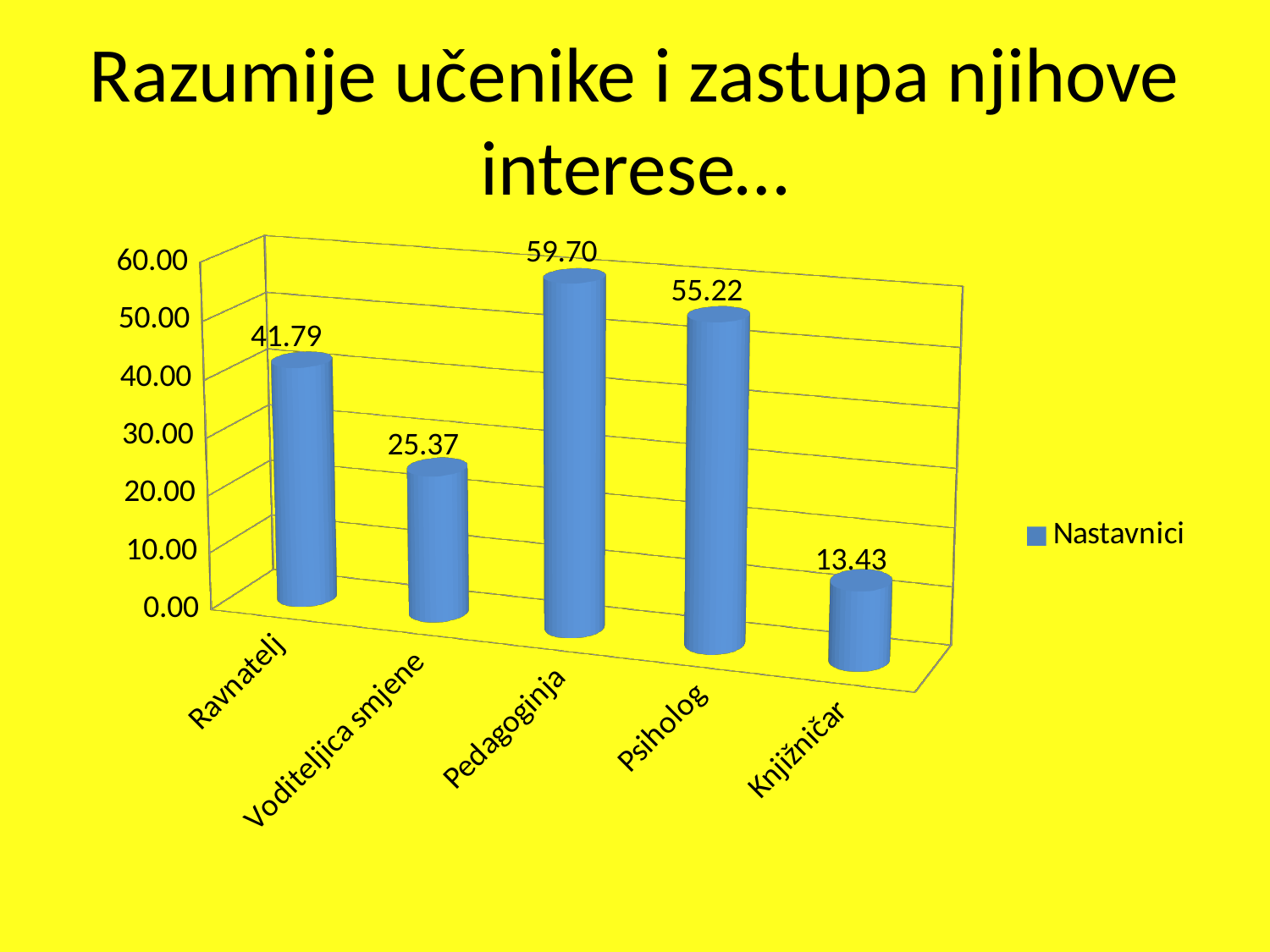
What kind of chart is shown on the slide? Bar chart What is the value for Voditeljica smjene? 25.37 Which category has the highest value? Pedagoginja How many categories are shown on the x axis? 5 How many series does the legend list? 1 What is the value for Psiholog? 55.22 Which category has the lowest value? Knjižničar What is the value for Ravnatelj? 41.79 What is the value for Pedagoginja? 59.70 What is the difference between the values for Pedagoginja and Psiholog? 4.48 What is the value for Knjižničar? 13.43 Which is larger, the value for Ravnatelj or the value for Voditeljica smjene? Ravnatelj